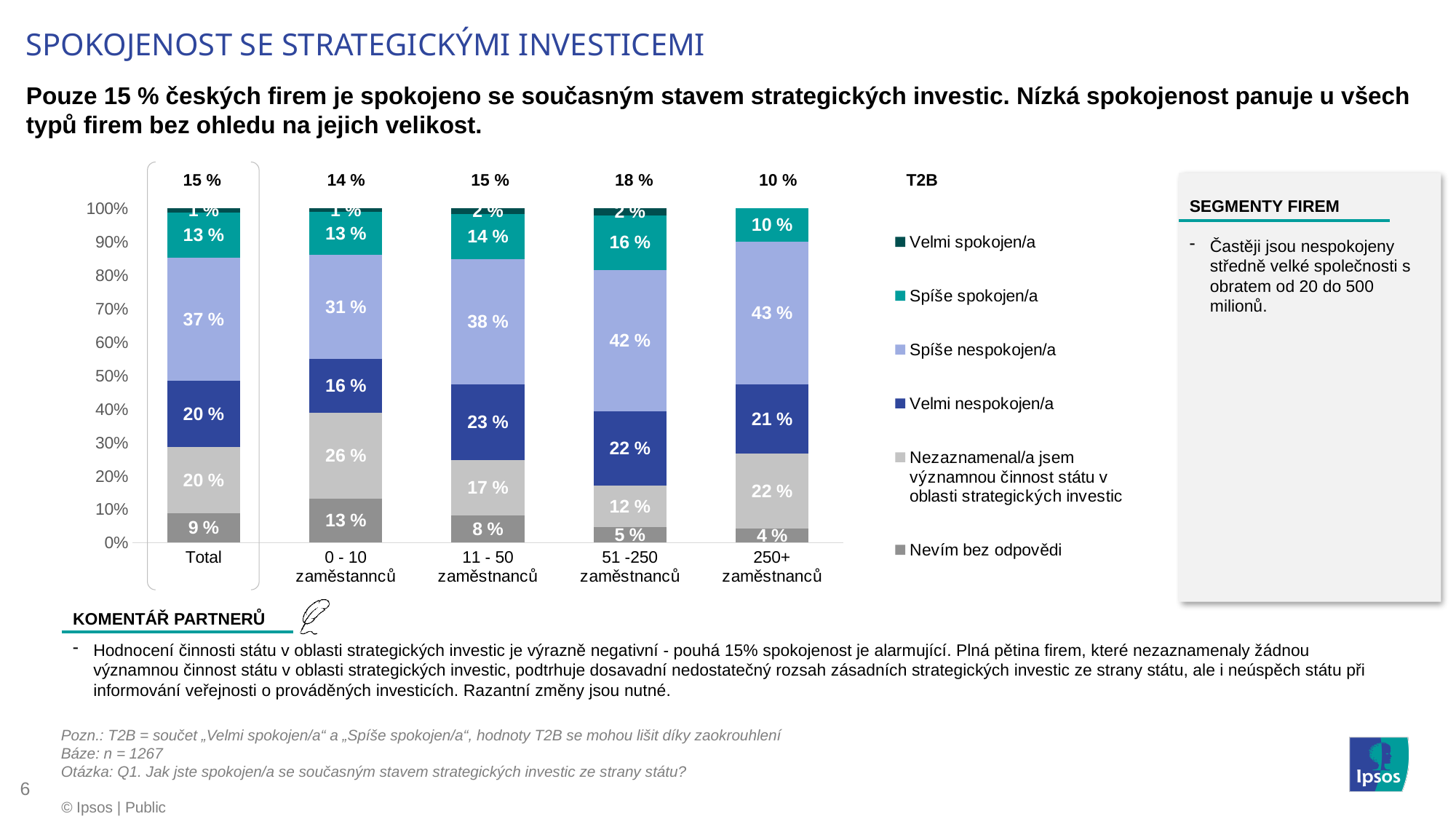
What is the T2B value shown above the "51 -250 zaměstnanců" bar? 18 % Which is larger: the "Spíše spokojen/a" value for "Total" or for "51 -250 zaměstnanců"? 51 -250 zaměstnanců Which category has the highest "Velmi nespokojen/a" value? 11 - 50 zaměstnanců Which legend entry is shown in the darkest teal colour at the top of the bars? Velmi spokojen/a What is the value of "Nezaznamenal/a jsem významnou činnost státu v oblasti strategických investic" for the "0 - 10 zaměstnanců" category? 26 % How many series does the chart legend list? 6 How many categories are shown along the x axis of the chart? 5 What is the difference between the "Spíše nespokojen/a" values for "51 -250 zaměstnanců" and "0 - 10 zaměstnanců"? 11 % What is the value of "Spíše nespokojen/a" for the "250+ zaměstnanců" category? 43 % Which category has the lowest T2B value shown above the bars? 250+ zaměstnanců Which category has the lowest "Nevím bez odpovědi" value? 250+ zaměstnanců What kind of chart is shown on the slide? Stacked bar chart